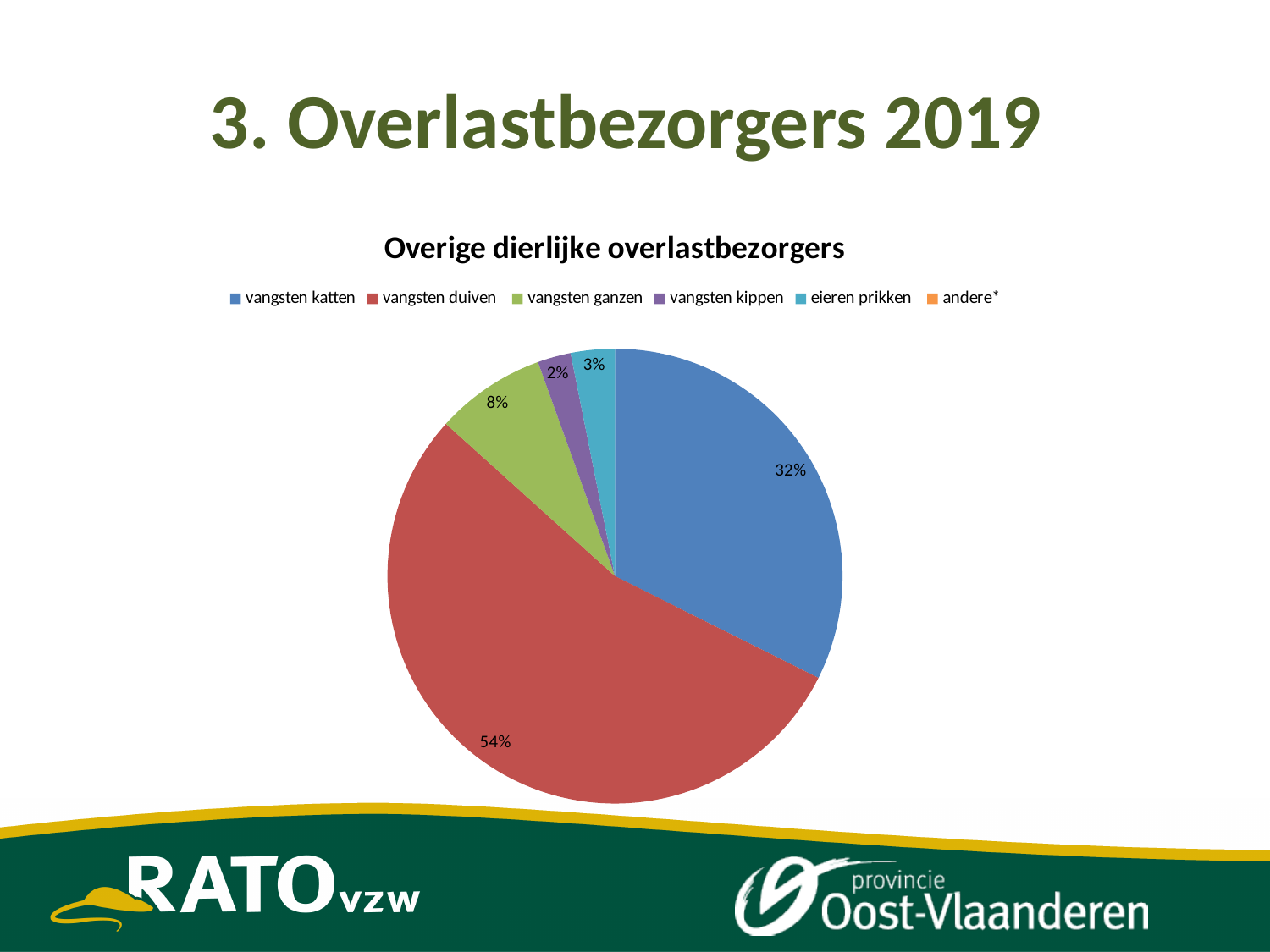
How many entries does the legend list? 6 What percentage of the pie is 'vangsten katten'? 32% Which is larger, 'vangsten ganzen' or 'eieren prikken'? vangsten ganzen Which category has the largest slice of the pie? vangsten duiven What type of chart is shown on the slide? pie chart What is the title of the chart? Overige dierlijke overlastbezorgers What share does 'eieren prikken' have in the pie? 3% What share does 'vangsten ganzen' have in the pie? 8% What is the difference in percentage points between 'vangsten duiven' and 'vangsten katten'? 22 What percentage of the pie is 'vangsten duiven'? 54% What percentage is shown for 'vangsten kippen'? 2% Which labelled slice is the smallest in the pie? vangsten kippen